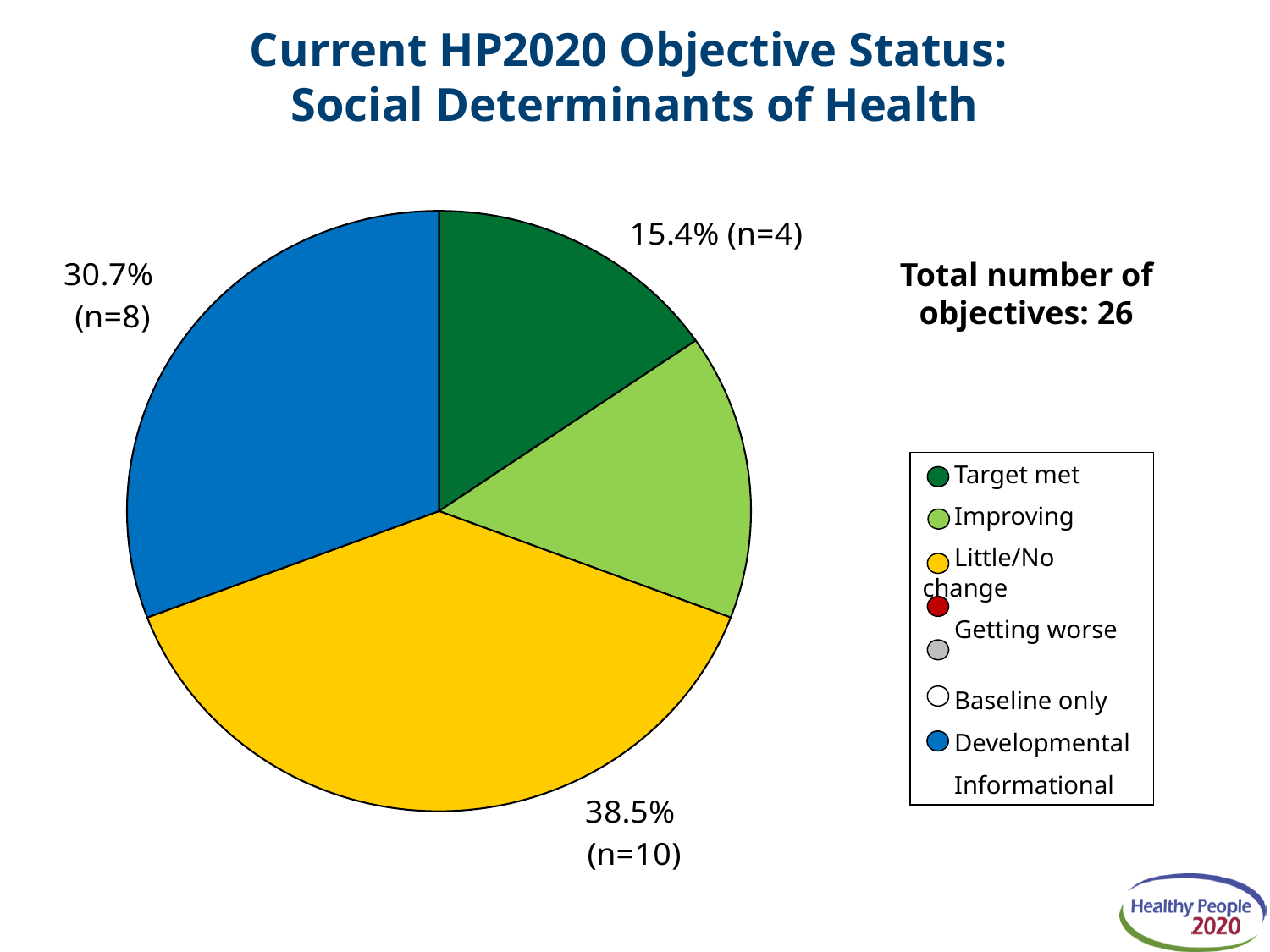
What kind of chart is shown on the slide? Pie chart What is the total number of objectives stated on the slide? 26 How many slices does the pie chart have? 4 What percentage of objectives are in the Little/No change category? 38.5% Which category has the largest slice of the pie? Little/No change What percentage of objectives have met their target (Target met)? 15.4% How many more objectives are in the Little/No change category than in the Target met category? 6 How many categories does the legend list? 7